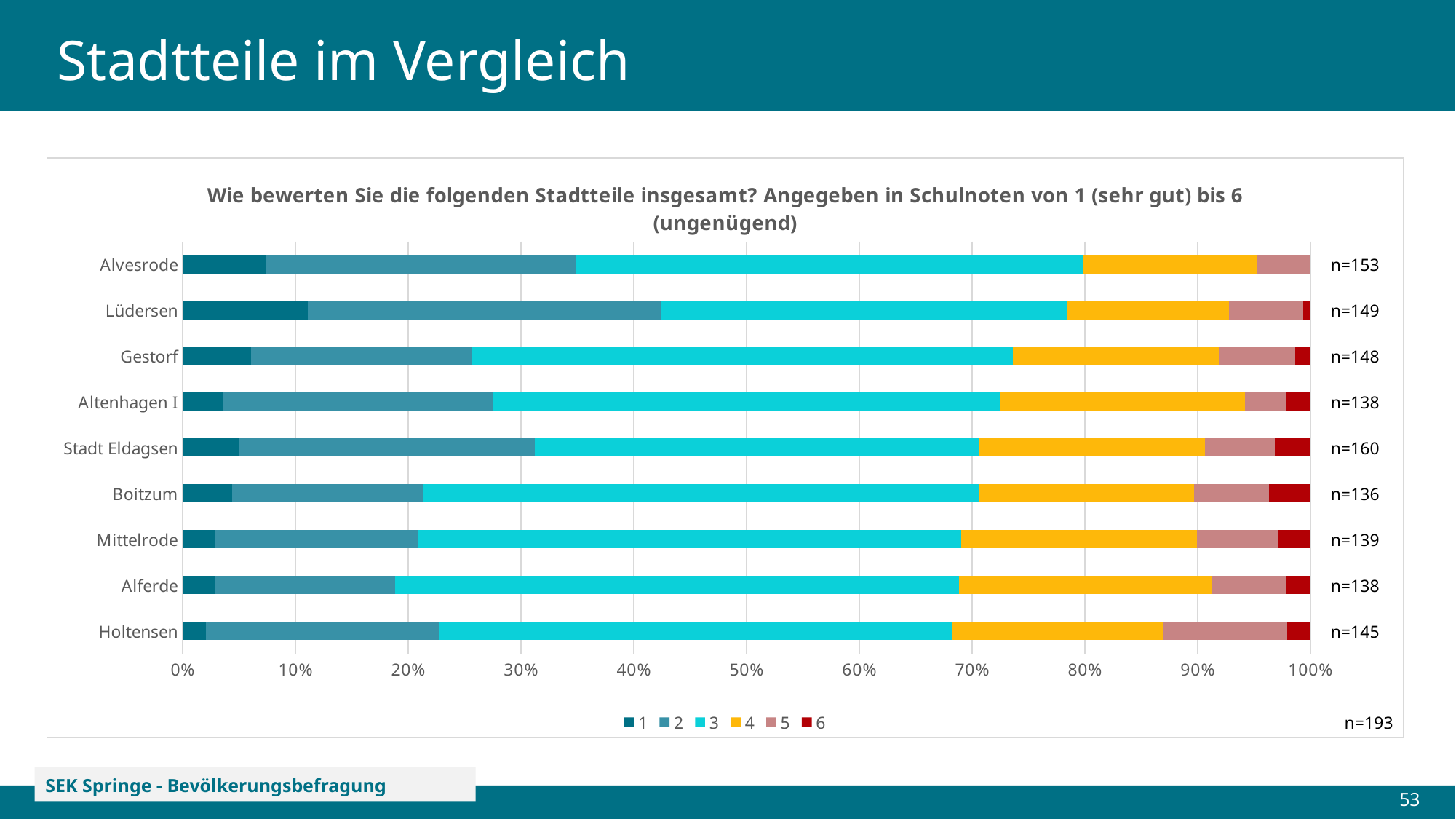
How many Stadtteile (categories) are plotted in the chart? 9 What is the overall n value printed at the bottom right of the chart? n=193 What kind of chart is shown on the slide? stacked bar chart Which has a larger n value, Lüdersen or Holtensen? Lüdersen Is the share of grade 1 for Lüdersen greater or less than 10%? greater What is the n value printed next to the bar for Alvesrode? n=153 How many series does the legend list? 6 What is the n value printed next to the bar for Boitzum? n=136 Is the share of grade 1 for Holtensen greater or less than 10%? less What is the n value printed next to the bar for Stadt Eldagsen? n=160 Which Stadtteil has the highest n value printed next to its bar? Stadt Eldagsen Which Stadtteil has the lowest n value printed next to its bar? Boitzum